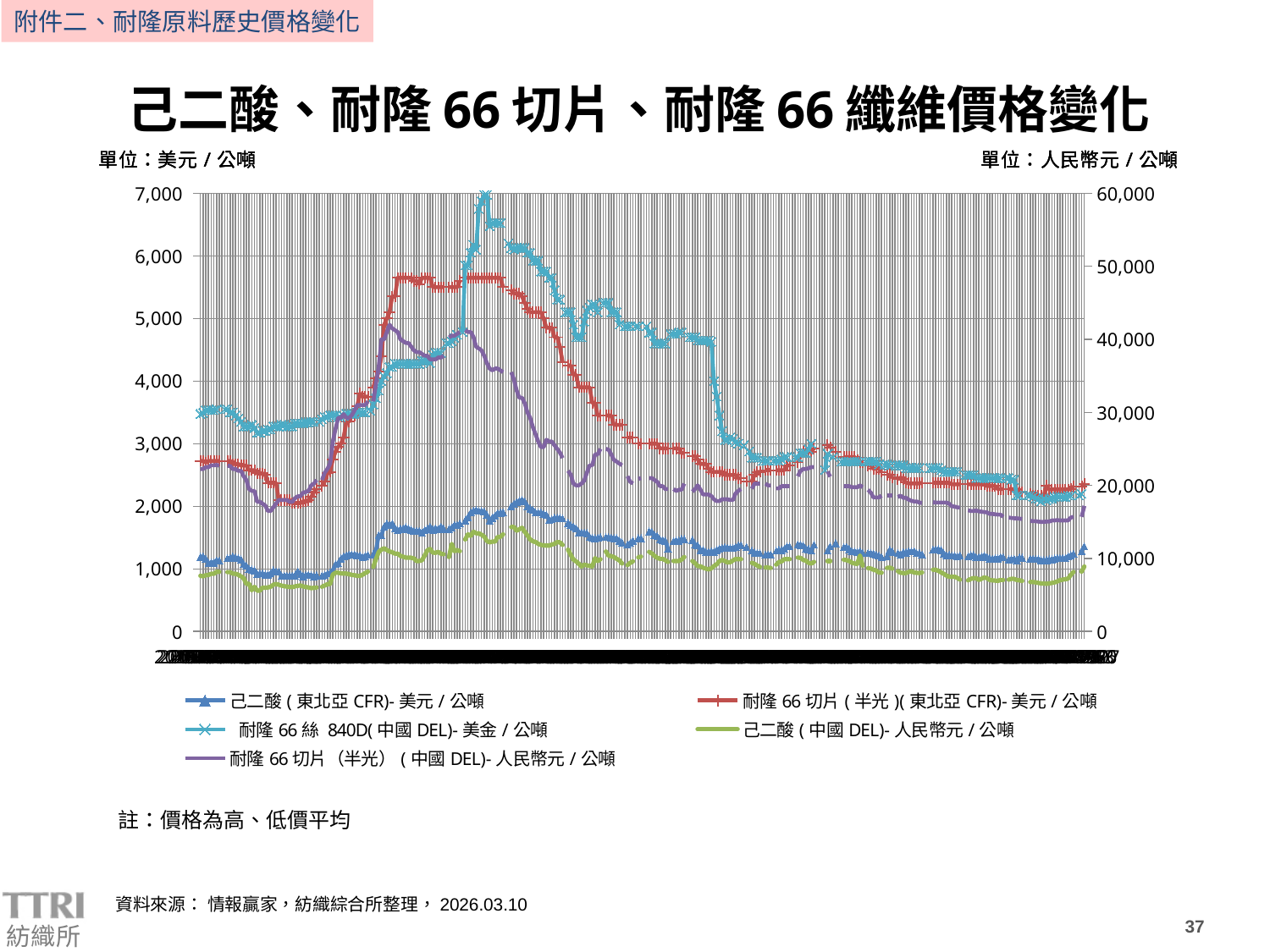
What kind of chart is shown on the slide? line chart Among the three series priced in 美元/公噸 (left axis), which one stays lowest throughout the chart? 己二酸(東北亞 CFR)-美元/公噸 How many series does the legend list? 5 Which series reaches the highest point on the chart? 耐隆66絲 840D(中國 DEL)-美金/公噸 Is the peak value of 耐隆66絲 840D(中國 DEL) greater or less than 6,000 on the left axis? greater Which series has the higher peak: 耐隆66絲 840D(中國 DEL) or 耐隆66切片(半光)(東北亞 CFR)? 耐隆66絲 840D(中國 DEL) What unit is shown for the right-hand axis of the chart? 人民幣元/公噸 Is the peak value of 耐隆66切片(半光)(東北亞 CFR) greater or less than 5,000 on the left axis? greater What is the title of the chart? 己二酸、耐隆66切片、耐隆66纖維價格變化 Comparing the start and the end of the chart, does the 耐隆66絲 840D(中國 DEL) series end higher or lower than it started? lower Does the 己二酸(東北亞 CFR) series ever rise above 3,000 on the left axis? no From its peak to the right end of the chart, does the 耐隆66絲 840D(中國 DEL) series rise or fall? fall